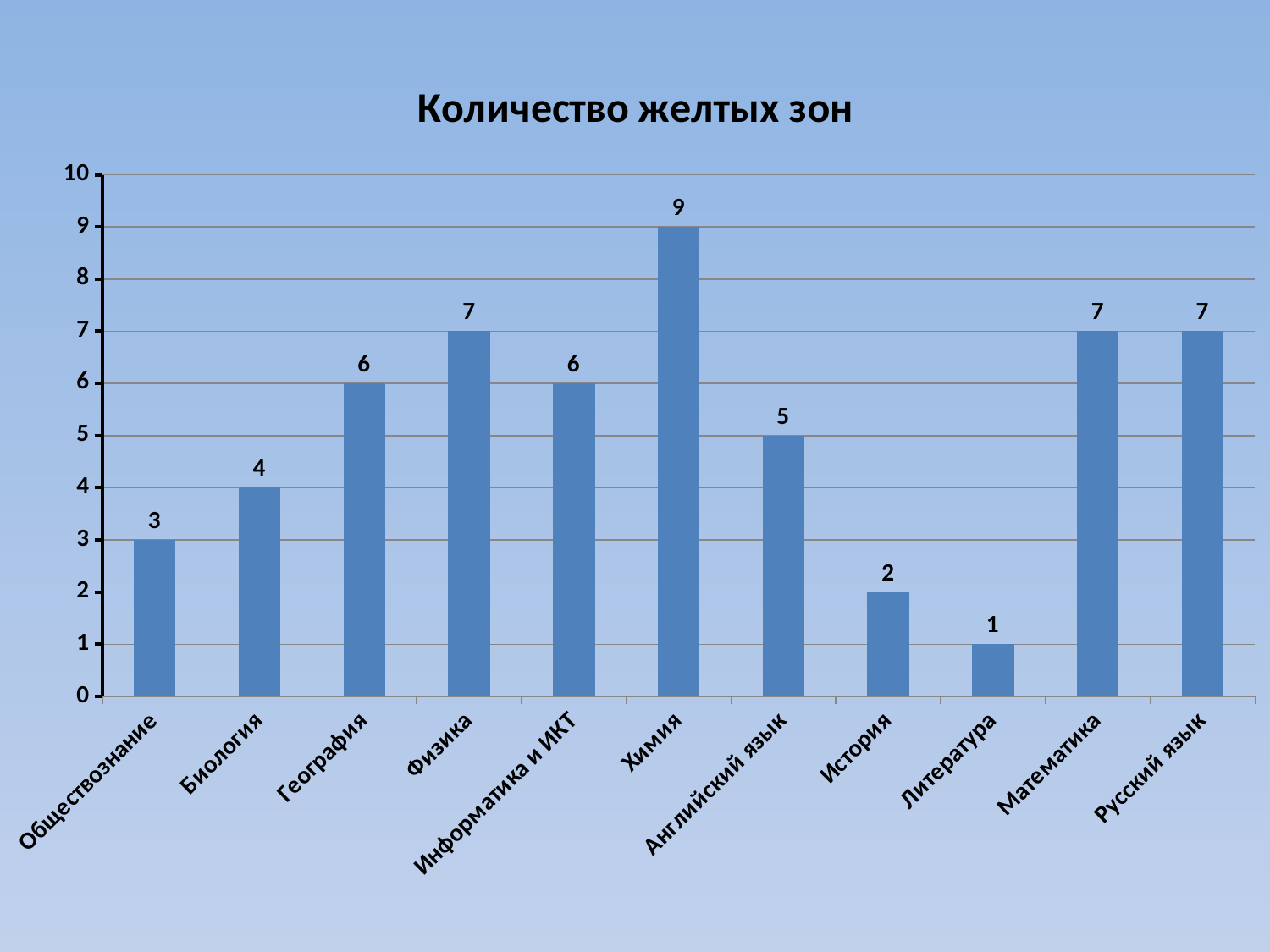
Which is larger, the value for Биология or the value for Английский язык? Английский язык What is the difference between the values for Химия and История? 7 What is the difference between the values for Физика and Обществознание? 4 Which category has the lowest value? Литература What is the value for Информатика и ИКТ? 6 How many categories are shown on the x axis? 11 Is the value for Математика greater or less than 5? greater Which category has the highest value? Химия What kind of chart is shown on the slide? bar chart What is the value for Химия? 9 What is the value for Литература? 1 What is the title of the chart? Количество желтых зон